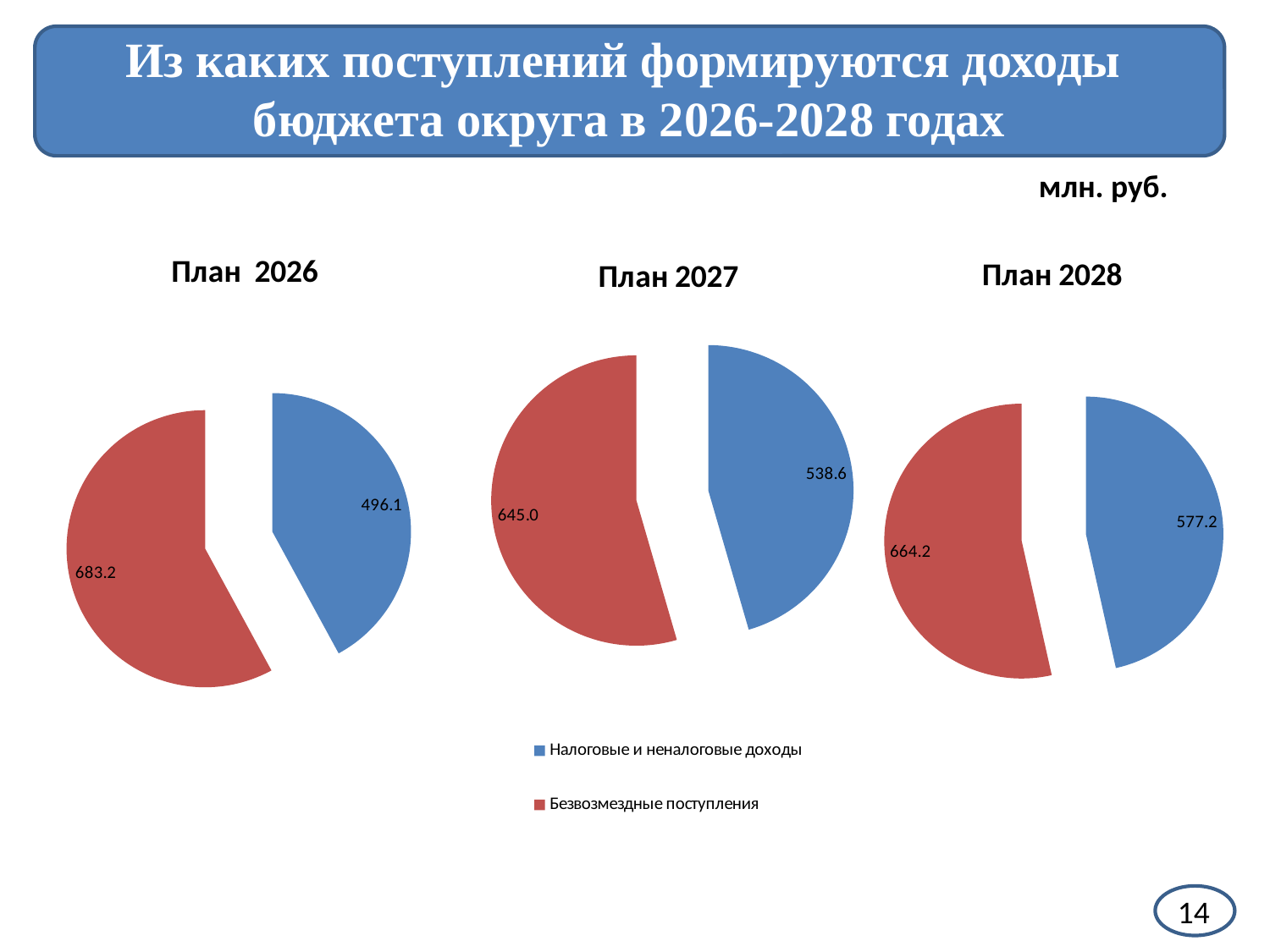
In the План 2028 chart, what is the value for Налоговые и неналоговые доходы? 577.2 In the План 2026 chart, what is the value for Налоговые и неналоговые доходы? 496.1 In the План 2026 chart, which category has the larger value? Безвозмездные поступления What type of chart is used on this slide? Pie chart How many series does the legend list? 2 In the План 2028 chart, what is the difference between Безвозмездные поступления and Налоговые и неналоговые доходы? 87.0 In the План 2028 chart, which category has the smaller value? Налоговые и неналоговые доходы In the План 2027 chart, what is the value for Безвозмездные поступления? 645.0 What is the total of the two values in the План 2026 chart? 1179.3 Is the value for Налоговые и неналоговые доходы larger in the План 2026 chart or in the План 2028 chart? План 2028 How many slices does the План 2027 pie chart have? 2 In the План 2027 chart, what is the difference between Безвозмездные поступления and Налоговые и неналоговые доходы? 106.4